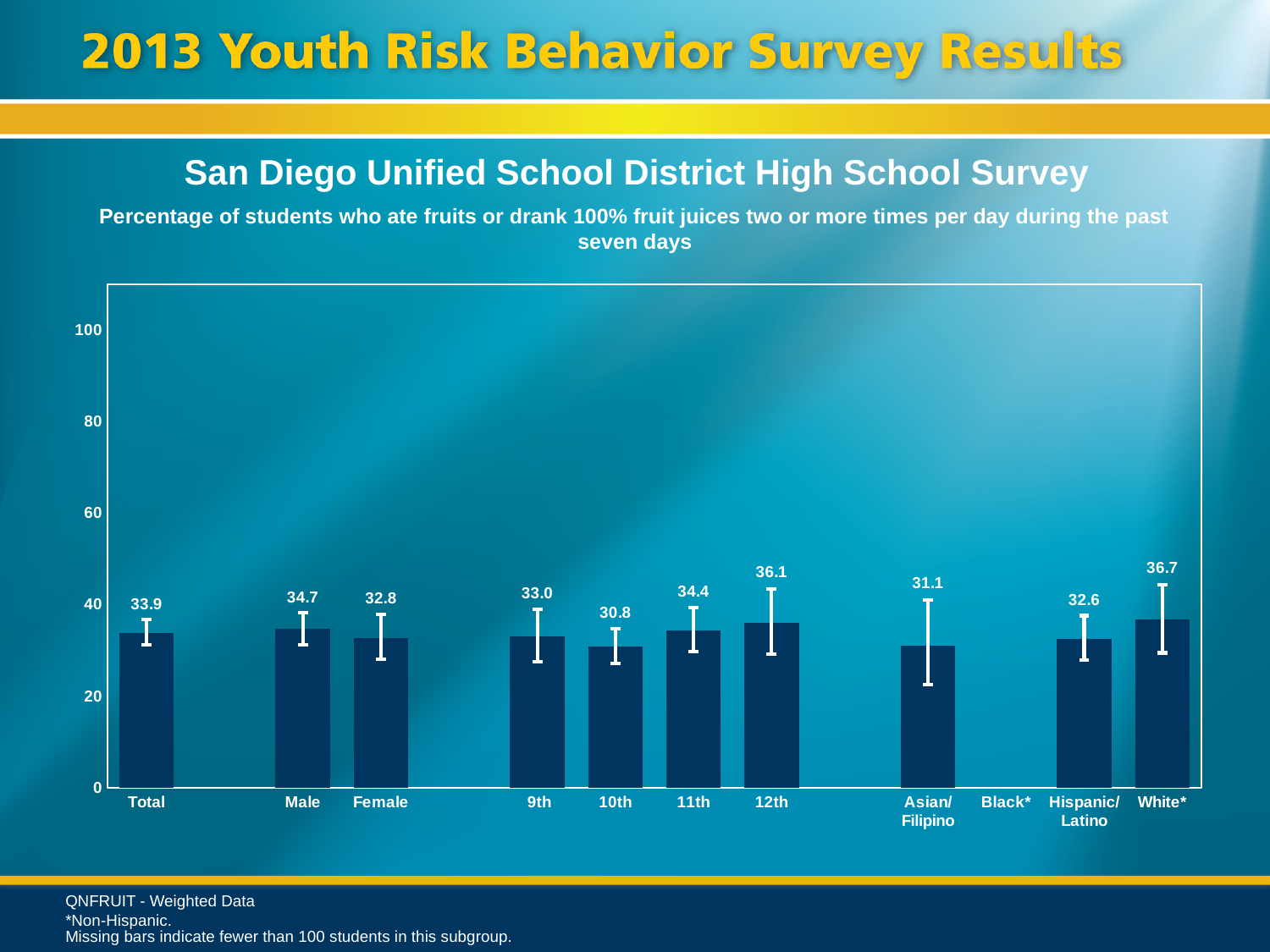
Which category has the lowest value among the plotted bars? 10th What is the difference between the 12th grade and 9th grade values? 3.1 How many bars are plotted on the chart? 10 What kind of chart is shown? bar chart Which category has the highest value? White* What is the value for Asian/Filipino students? 31.1 Is the value for Hispanic/Latino greater or less than 40? less What is the value for 10th grade students? 30.8 Which category label on the x axis has no bar plotted? Black* What is the difference between the Male and Female values? 1.9 Which is larger, the value for 11th grade or the value for 10th grade? 11th What is the value for Total? 33.9